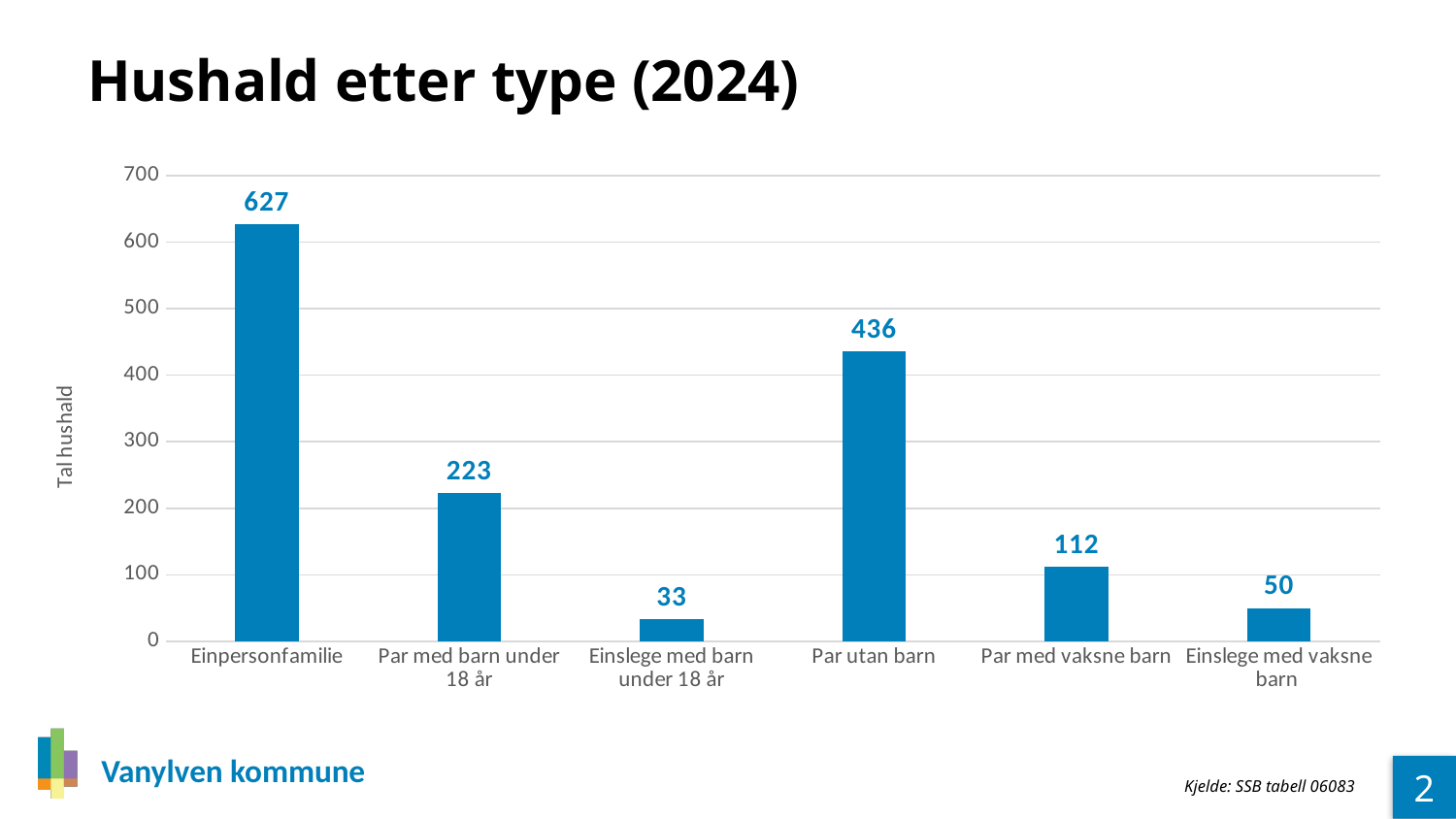
How many categories are shown on the x axis? 6 What is the value for Par utan barn? 436 What is the value for Einslege med barn under 18 år? 33 What kind of chart is shown on the slide? bar chart What is the difference between Einpersonfamilie and Par utan barn? 191 Is the value for Einslege med vaksne barn greater or less than 100? less Which category has the lowest value? Einslege med barn under 18 år What is the value for Einpersonfamilie? 627 What is the title of the chart? Hushald etter type (2024) What is the value for Par med vaksne barn? 112 Which is larger, Par med barn under 18 år or Par med vaksne barn? Par med barn under 18 år Which category has the highest value? Einpersonfamilie